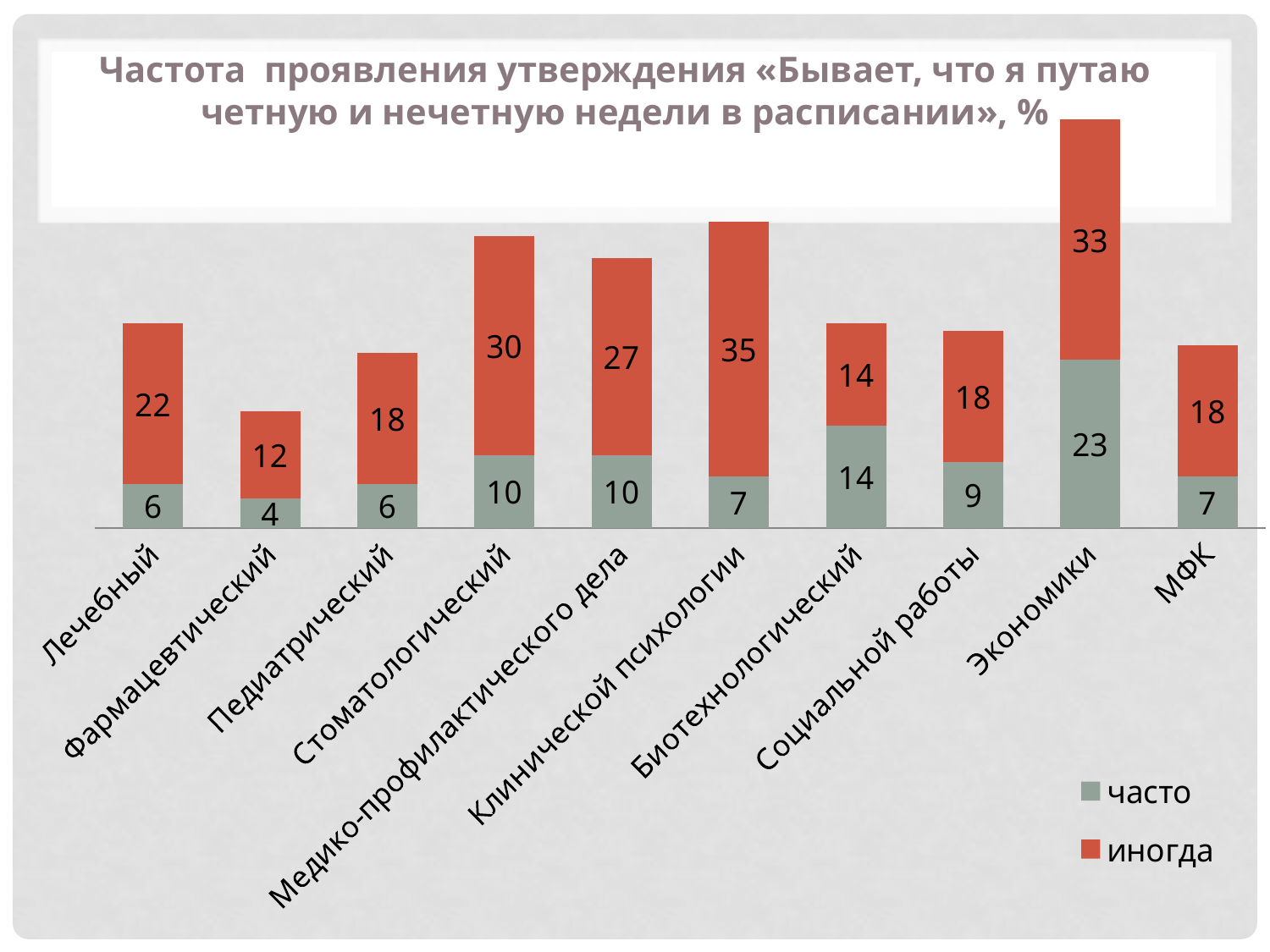
Which category has the lowest «иногда» value? Фармацевтический Which series is shown in red? иногда How many categories are shown on the x axis? 10 Which is larger: the «часто» value for Биотехнологический or for Социальной работы? Биотехнологический How many series does the legend list? 2 What is the value of «иногда» for Клинической психологии? 35 What is the value of «иногда» for Фармацевтический? 12 What kind of chart is shown on the slide? Stacked bar chart Which category has the highest «часто» value? Экономики What is the value of «часто» for Экономики? 23 What is the total of the stacked bar for Экономики? 56 What is the difference between the «иногда» values for Стоматологический and Педиатрический? 12